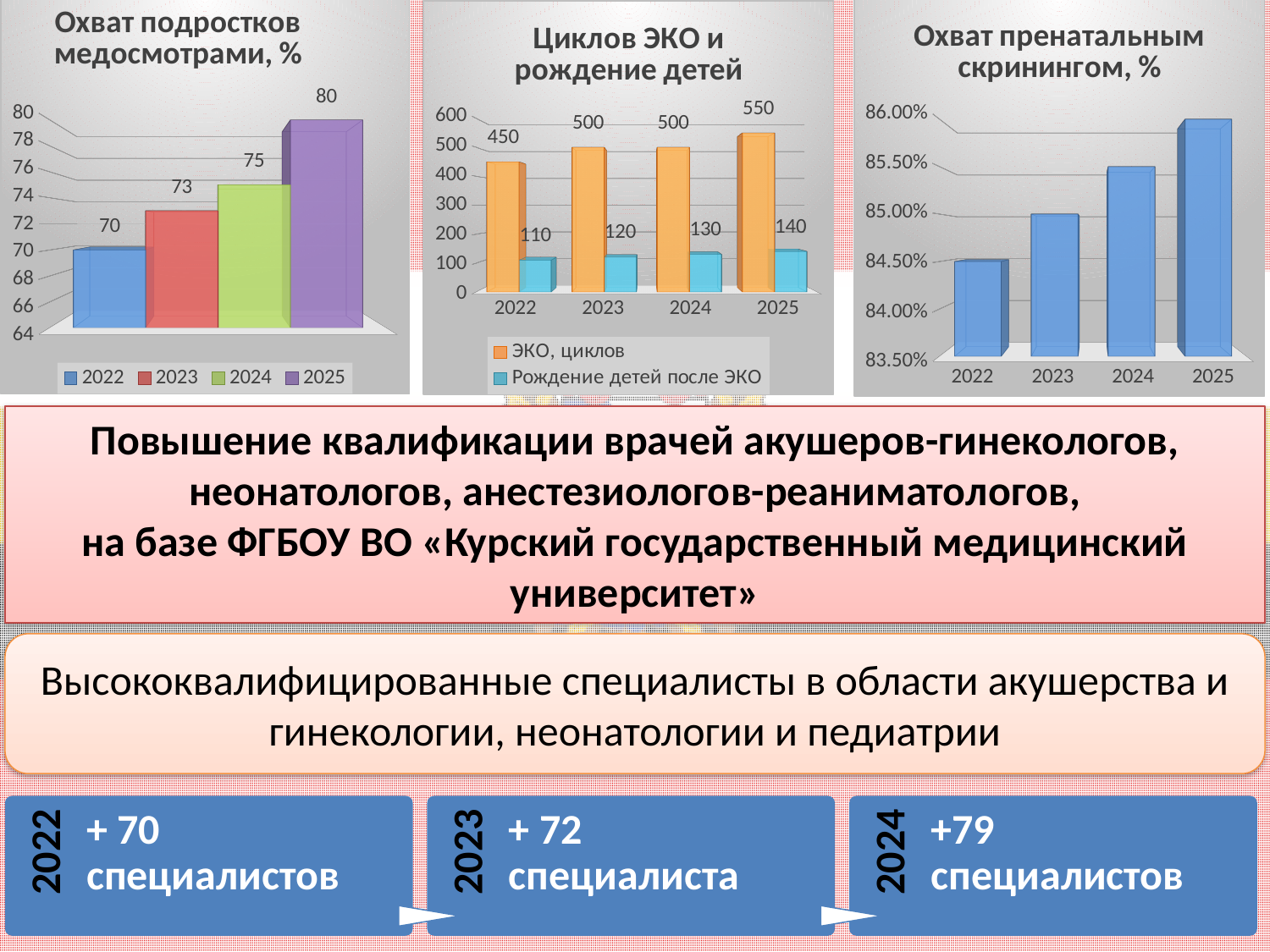
In the chart 'Охват подростков медосмотрами, %', what is the value for 2023? 73 In the chart 'Циклов ЭКО и рождение детей', what is the difference between 'ЭКО, циклов' and 'Рождение детей после ЭКО' in 2022? 340 What kind of chart is 'Охват пренатальным скринингом, %'? bar chart In the chart 'Охват пренатальным скринингом, %', is the value for 2022 greater or less than 85.00%? less In the chart 'Охват пренатальным скринингом, %', is the value for 2025 greater or less than 85.50%? greater In the chart 'Циклов ЭКО и рождение детей', which year has the lowest value of 'Рождение детей после ЭКО'? 2022 In the chart 'Охват подростков медосмотрами, %', what is the difference between the 2025 and 2022 values? 10 In the chart 'Циклов ЭКО и рождение детей', what is the value of 'Рождение детей после ЭКО' for 2024? 130 In the chart 'Циклов ЭКО и рождение детей', how many series does the legend list? 2 In the chart 'Охват подростков медосмотрами, %', which year has the highest value? 2025 In the chart 'Циклов ЭКО и рождение детей', what is the value of 'ЭКО, циклов' for 2025? 550 In the chart 'Охват подростков медосмотрами, %', do the values rise or fall from 2022 to 2025? rise